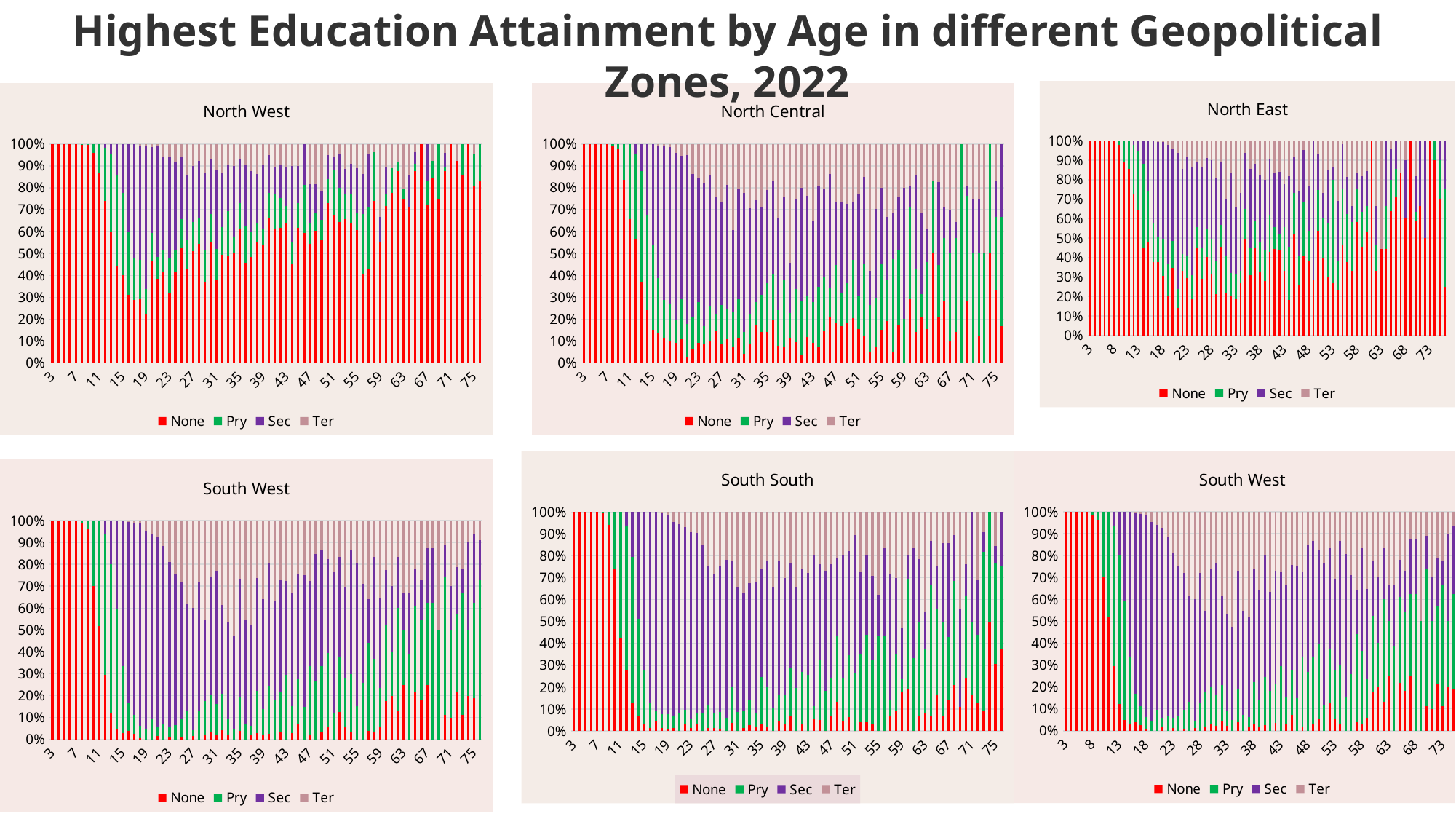
In the North Central chart, does the None share rise or fall from age 3 to age 23? fall In the North East chart, is the None share at age 3 greater or less than 90%? greater How many series does the legend of the South West chart at the bottom left of the slide list? 4 In the North West chart, is the None share at age 3 greater or less than 90%? greater What are the legend entries in the North East chart? None, Pry, Sec, Ter In the South South chart, is the None share at age 19 greater or less than 50%? less How many series does the legend of the North Central chart list? 4 What kind of chart is the North West chart? bar chart How many charts are shown on the slide? 6 In the North West chart, does the None share generally rise or fall from age 23 to age 75? rise